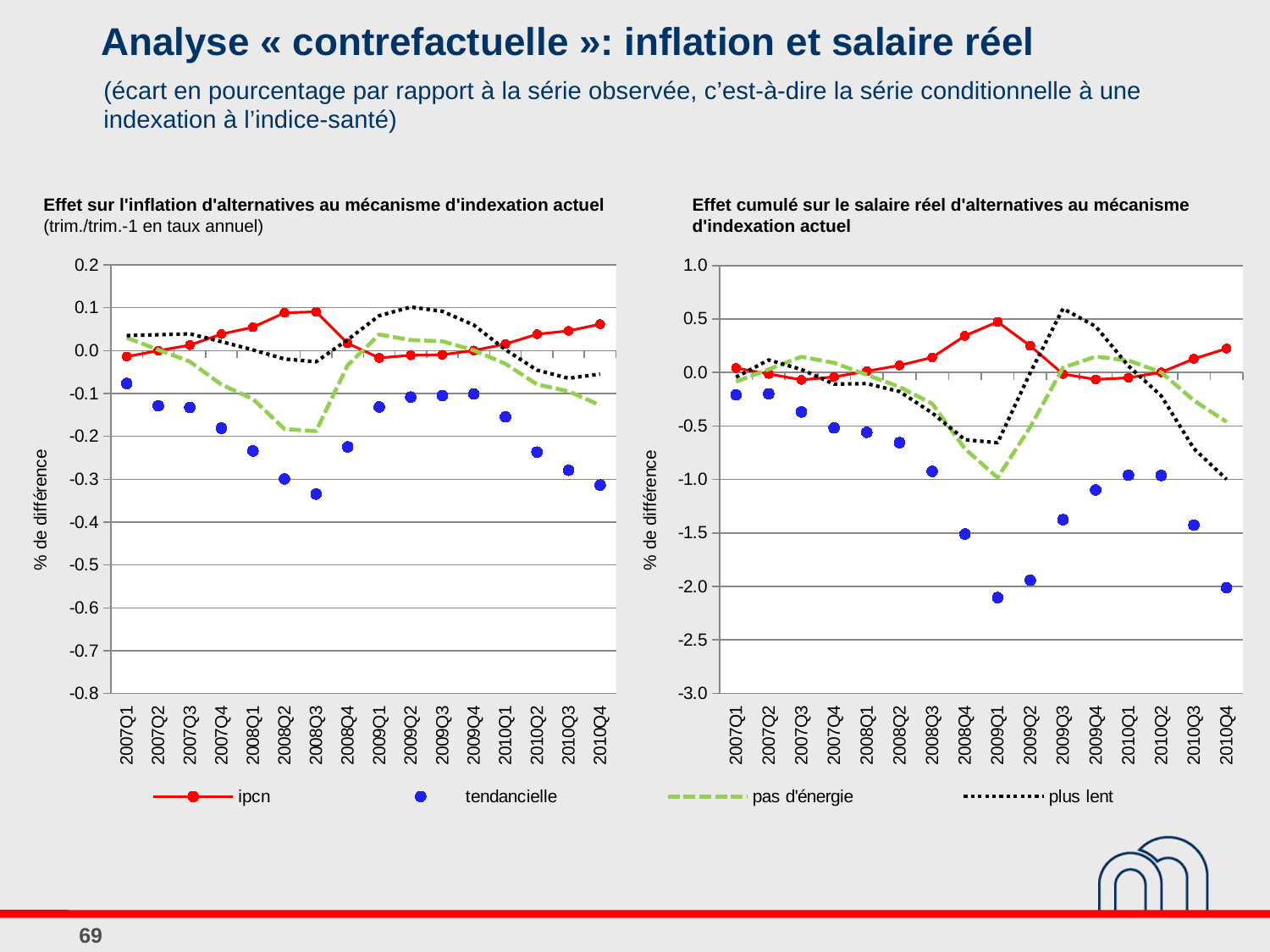
In the right chart (Effet cumulé sur le salaire réel), is the value of 'tendancielle' at 2009Q1 greater or less than -1.5? less In the left chart (Effet sur l'inflation), in which quarter does the 'tendancielle' series reach its lowest value? 2008Q3 How many series does the legend list for the charts on this slide? 4 In the left chart (Effet sur l'inflation), which is larger at 2008Q3: 'ipcn' or 'tendancielle'? ipcn In the left chart (Effet sur l'inflation), is the value of 'tendancielle' at 2008Q3 greater or less than -0.2? less What is the y-axis label of the right chart (Effet cumulé sur le salaire réel)? % de différence In the right chart (Effet cumulé sur le salaire réel), which series has the lowest value at 2009Q1? tendancielle In the right chart (Effet cumulé sur le salaire réel), is the value of 'ipcn' at 2009Q1 greater or less than 0.0? greater In the left chart (Effet sur l'inflation), how many quarters are shown on the x axis? 16 In the right chart (Effet cumulé sur le salaire réel), does the 'tendancielle' series rise or fall from 2007Q1 to 2009Q1? fall In the right chart (Effet cumulé sur le salaire réel), in which quarter does the 'tendancielle' series reach its lowest value? 2009Q1 What kind of chart is the left chart, 'Effet sur l'inflation d'alternatives au mécanisme d'indexation actuel'? line chart